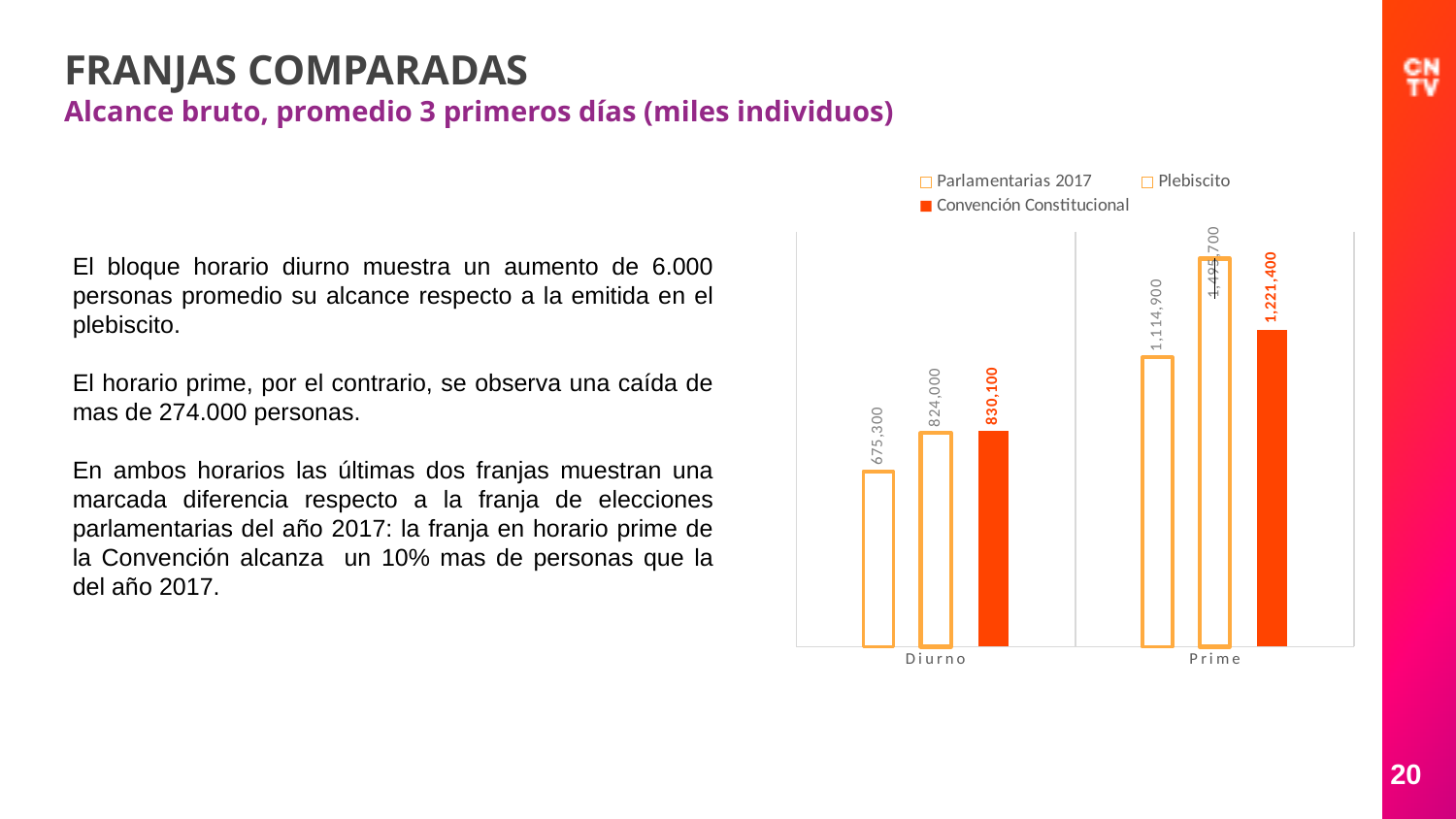
What kind of chart is shown on the slide? Bar chart What is the difference between the Convención Constitucional and Plebiscito values in the Diurno category? 6,100 How many series does the legend list? 3 What is the value for Parlamentarias 2017 in the Diurno category? 675,300 What is the value for Convención Constitucional in the Diurno category? 830,100 Which series has the highest value in the Prime category? Plebiscito What is the difference between the Convención Constitucional and Parlamentarias 2017 values in the Prime category? 106,500 What is the value for Plebiscito in the Diurno category? 824,000 Which series has the lowest value in the Diurno category? Parlamentarias 2017 Which is larger: the Convención Constitucional value for Diurno or the Parlamentarias 2017 value for Prime? Parlamentarias 2017 value for Prime What is the value for Convención Constitucional in the Prime category? 1,221,400 What is the value for Parlamentarias 2017 in the Prime category? 1,114,900